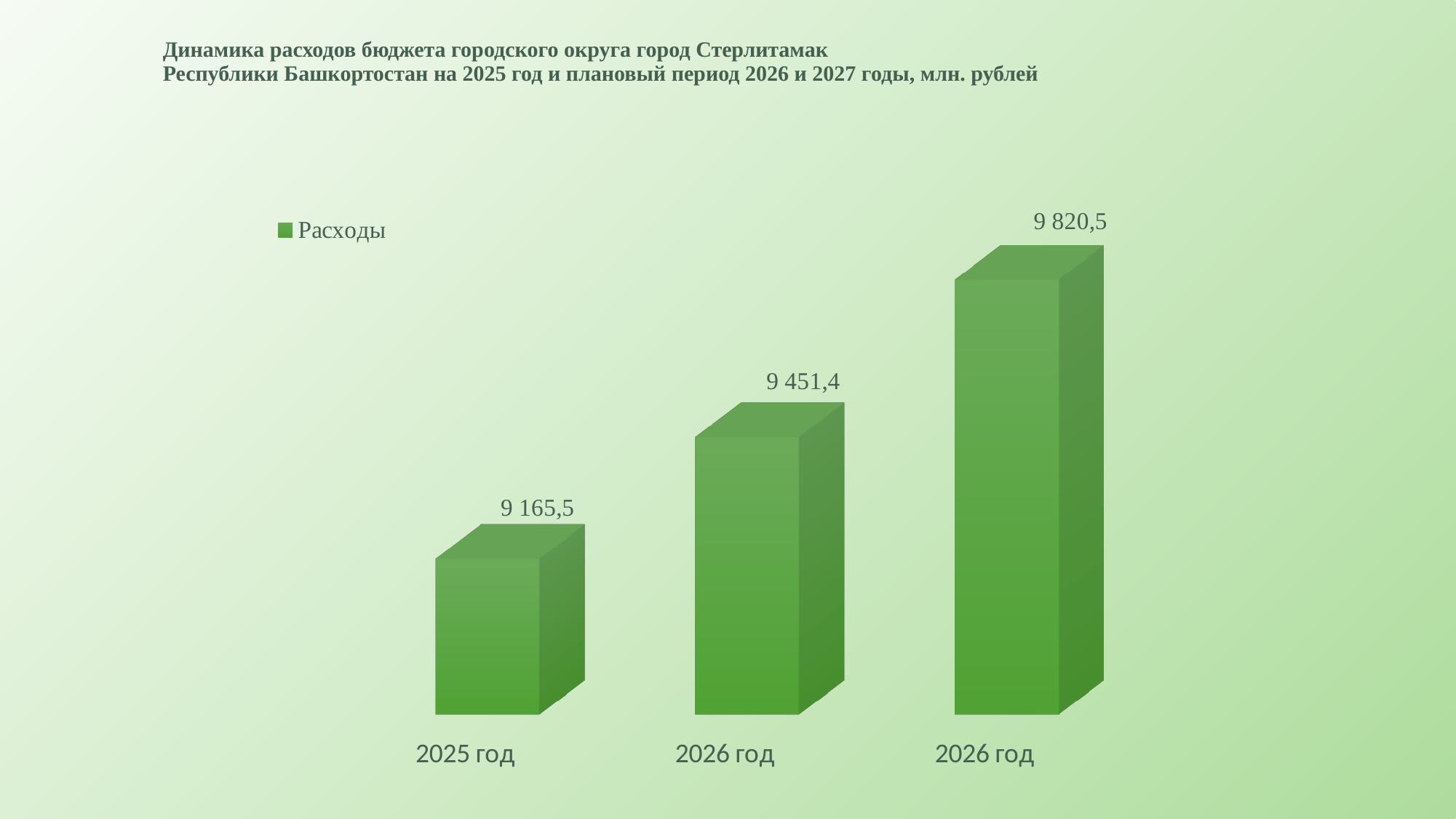
How many bars are shown in the chart? 3 Which is larger, the value for 2025 год or the value of the middle bar? the middle bar What is the value of the rightmost bar? 9 820,5 Which category has the lowest value? 2025 год How many series does the legend list? 1 What is the difference between the rightmost bar and the 2025 год bar? 655,0 What is the value of the bar for 2025 год? 9 165,5 What is the value of the middle bar? 9 451,4 What kind of chart is shown on the slide? bar chart Which bar has the highest value? the rightmost bar (9 820,5) What is the difference between the middle bar and the 2025 год bar? 285,9 What is the difference between the rightmost bar and the middle bar? 369,1